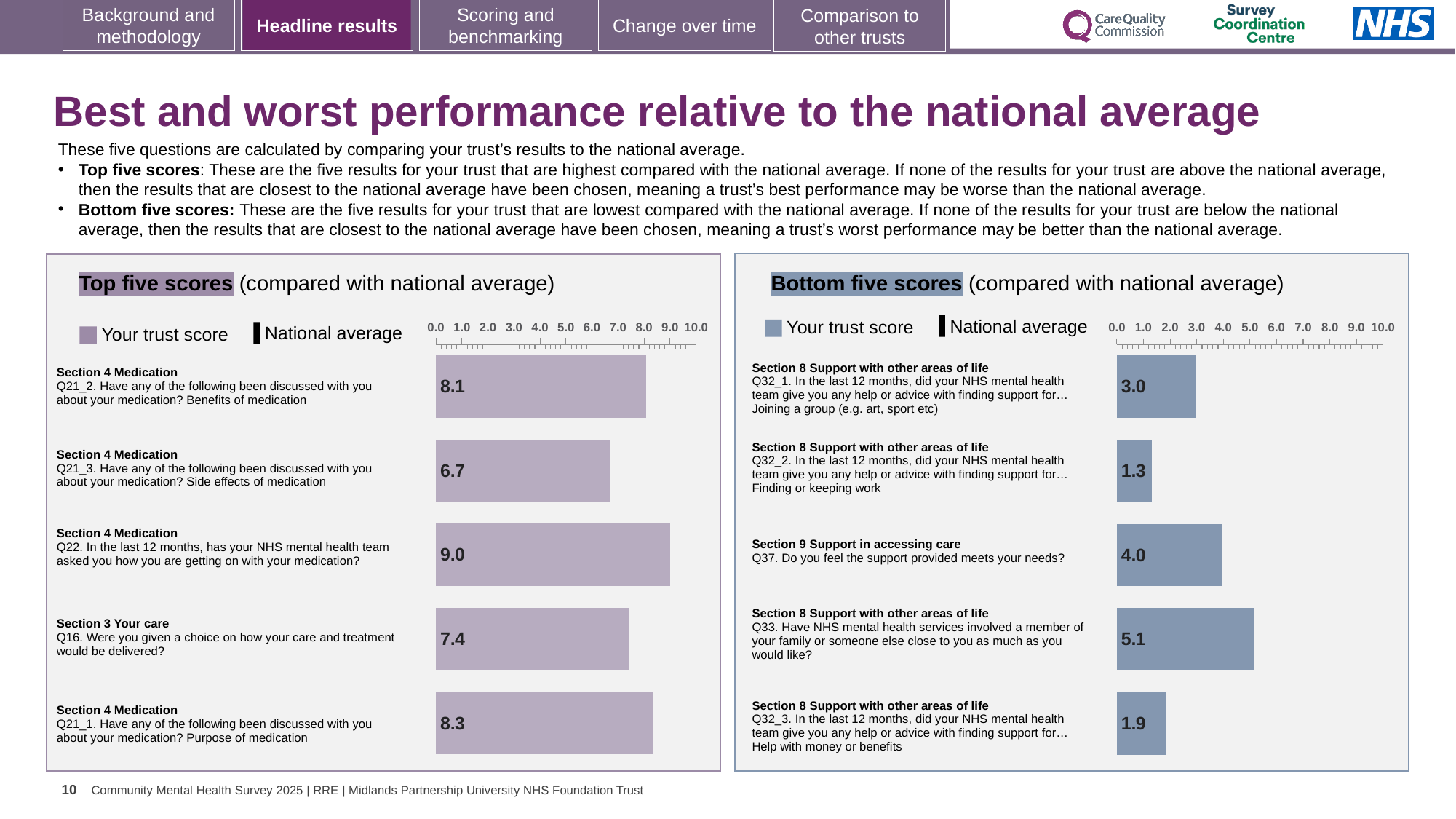
What type of chart is the Top five scores chart? Bar chart In the Bottom five scores chart, which question has the highest trust score? Q33. Have NHS mental health services involved a member of your family or someone else close to you as much as you would like? In the Bottom five scores chart, what is the trust score for Q32_3 (help with money or benefits)? 1.9 In the Top five scores chart, what is the trust score for Q22 (has your NHS mental health team asked you how you are getting on with your medication)? 9.0 In the Top five scores chart, which question has the lowest trust score? Q21_3. Side effects of medication In the Top five scores chart, what is the trust score for Q16 (were you given a choice on how your care and treatment would be delivered)? 7.4 How many series does the legend of the Bottom five scores chart list? 2 How many bars are plotted in the Top five scores chart? 5 In the Bottom five scores chart, what is the trust score for Q33 (have NHS mental health services involved a member of your family or someone else close to you as much as you would like)? 5.1 In the Bottom five scores chart, which question has the lowest trust score? Q32_2. Finding or keeping work In the Bottom five scores chart, which has the larger trust score: Q32_1 (joining a group) or Q37 (do you feel the support provided meets your needs)? Q37 In the Top five scores chart, what is the difference between the trust scores for Q22 and Q21_3? 2.3